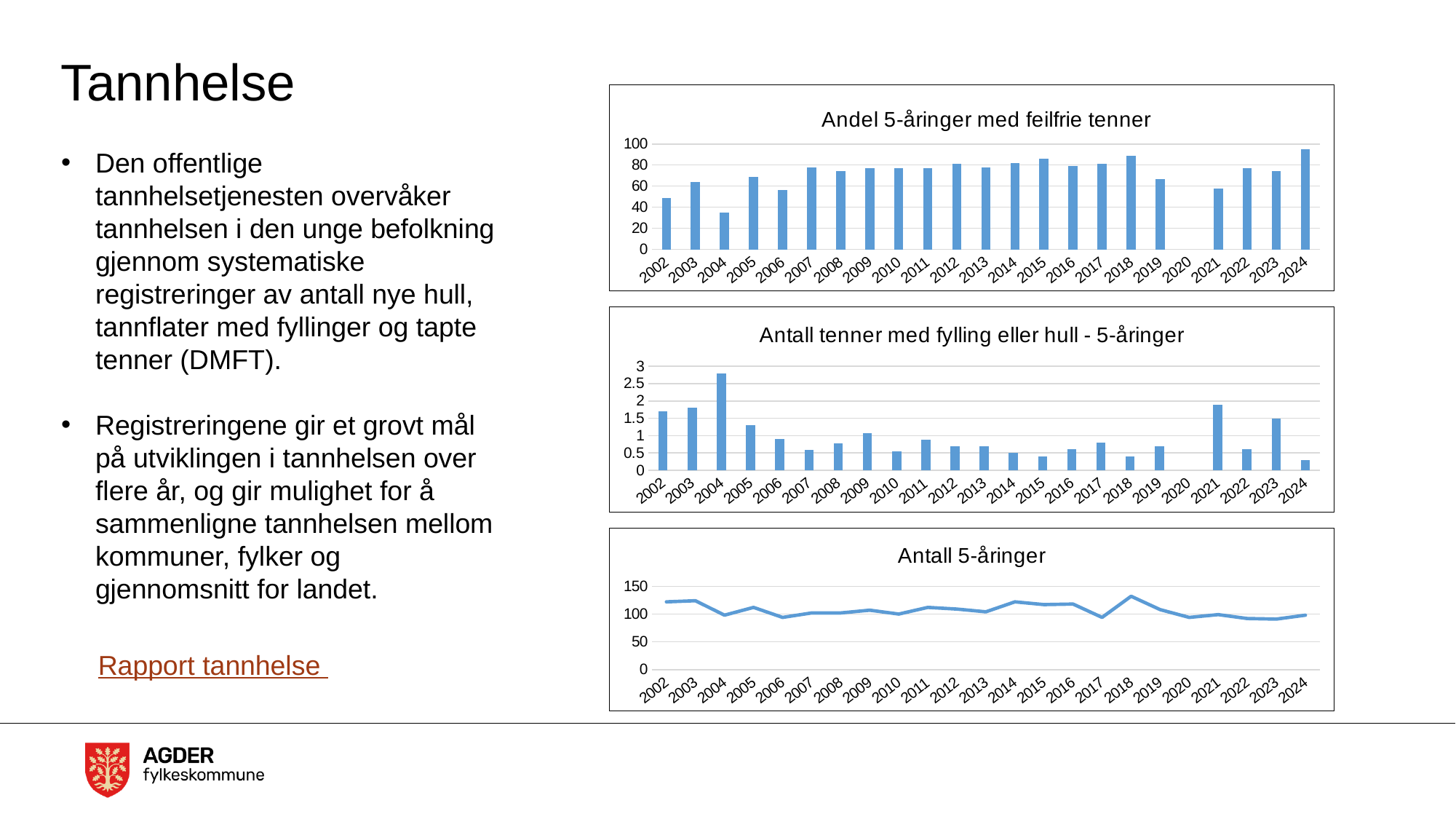
In the chart 'Antall tenner med fylling eller hull - 5-åringer', which is larger, the value for 2004 or the value for 2021? 2004 In the chart 'Antall tenner med fylling eller hull - 5-åringer', is the value for 2024 greater or less than 0.5? less How many year labels are shown on the x axis of the chart 'Antall 5-åringer'? 23 What type of chart is 'Andel 5-åringer med feilfrie tenner'? bar chart In the chart 'Andel 5-åringer med feilfrie tenner', is the value for 2018 greater or less than 80? greater What type of chart is 'Antall 5-åringer'? line chart In the chart 'Andel 5-åringer med feilfrie tenner', which year has the highest value? 2024 In the chart 'Antall tenner med fylling eller hull - 5-åringer', is the value for 2021 greater or less than 1.5? greater In the chart 'Andel 5-åringer med feilfrie tenner', which year has the lowest value among the years with a bar? 2004 In the chart 'Antall tenner med fylling eller hull - 5-åringer', which year has the highest value? 2004 In the chart 'Antall 5-åringer', which year has the highest value? 2018